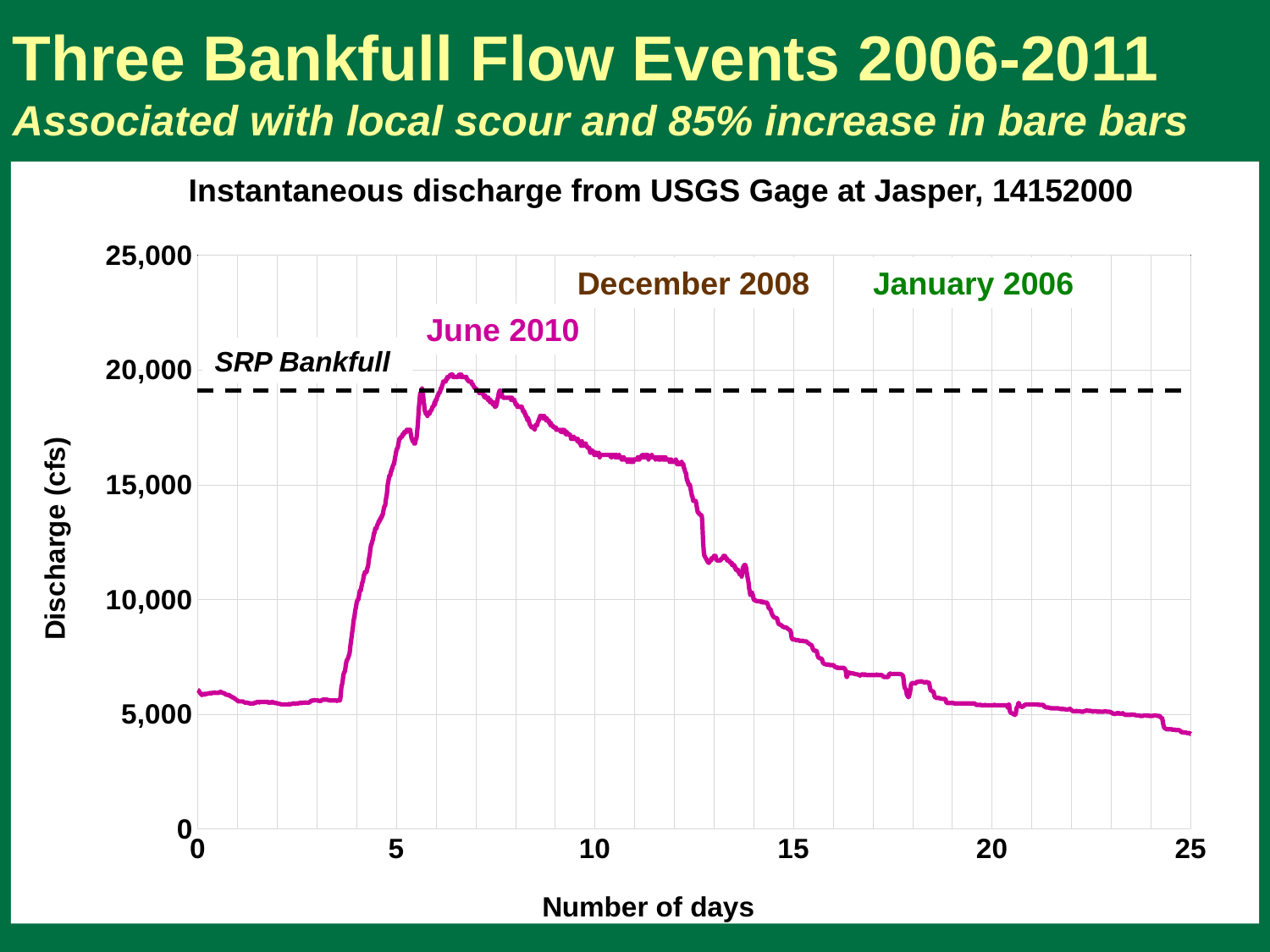
Is the discharge at day 25 greater or less than 5,000 cfs? less Is the discharge at day 10 greater or less than 15,000 cfs? greater Is the discharge at day 15 greater or less than 10,000 cfs? less What kind of chart is shown on the slide? line chart What is the title of the chart? Instantaneous discharge from USGS Gage at Jasper, 14152000 What does the dashed horizontal line on the chart represent? SRP Bankfull Does the June 2010 discharge line rise or fall between day 4 and day 6? rise Does the peak of the June 2010 line exceed the SRP Bankfull dashed line? yes Does the June 2010 discharge line rise or fall between day 10 and day 25? fall